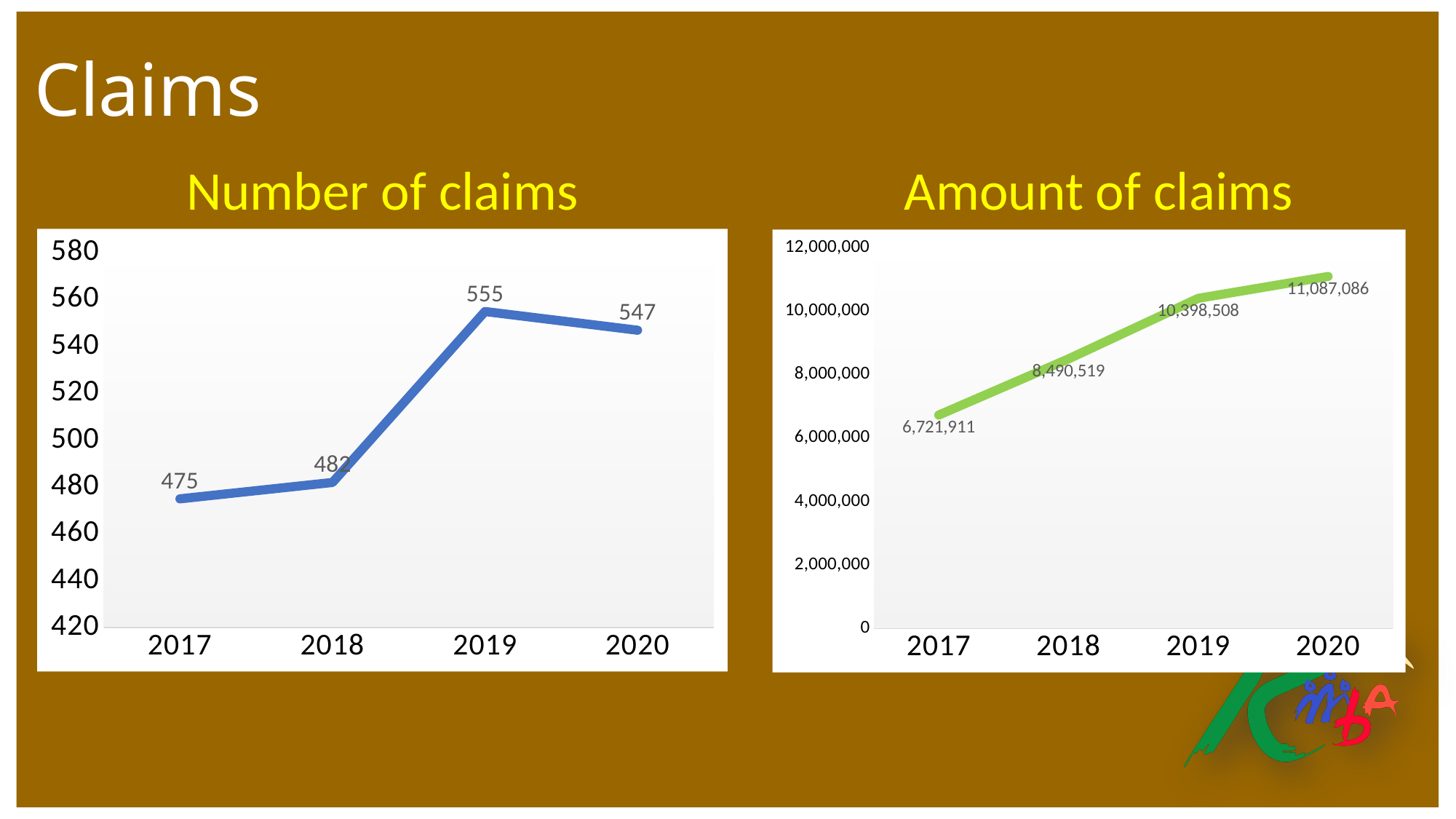
In the "Amount of claims" chart, what is the value for 2020? 11,087,086 In the "Number of claims" chart, what is the value for 2019? 555 In the "Number of claims" chart, which year has the lowest value? 2017 In the "Number of claims" chart, what is the difference between the 2019 and 2020 values? 8 How many years are plotted in the "Amount of claims" chart? 4 In the "Amount of claims" chart, what is the value for 2018? 8,490,519 In the "Amount of claims" chart, what is the difference between the 2020 and 2019 values? 688,578 In the "Amount of claims" chart, which year has the lowest value? 2017 In the "Number of claims" chart, which year has the highest value? 2019 In the "Number of claims" chart, which is larger, the value for 2018 or the value for 2020? 2020 What kind of chart is the "Number of claims" chart? Line chart In the "Number of claims" chart, what is the value for 2017? 475